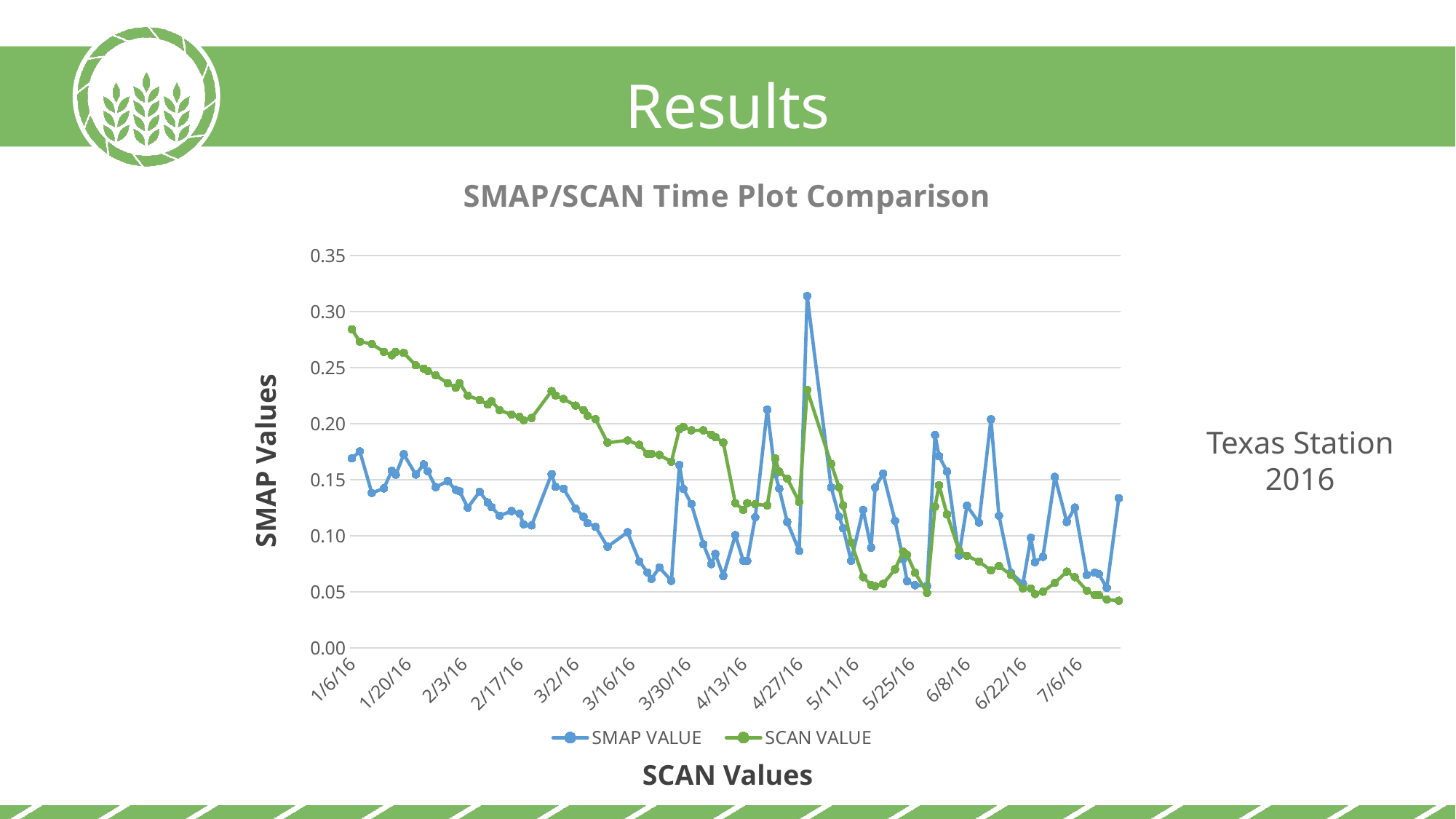
Is the SCAN VALUE at 3/2/16 greater or less than 0.20? greater Is the SCAN VALUE at the last plotted date greater or less than 0.05? less At 1/6/16, which series has the higher value, SMAP VALUE or SCAN VALUE? SCAN VALUE Which series is drawn in green? SCAN VALUE Is the highest SMAP VALUE point on the chart greater or less than 0.30? greater Does the SCAN VALUE series generally rise or fall from 1/6/16 to 7/6/16? fall Which series reaches the highest value anywhere on the chart? SMAP VALUE What is the title of the chart? SMAP/SCAN Time Plot Comparison How many series does the legend list? 2 What kind of chart is shown on the slide? line chart